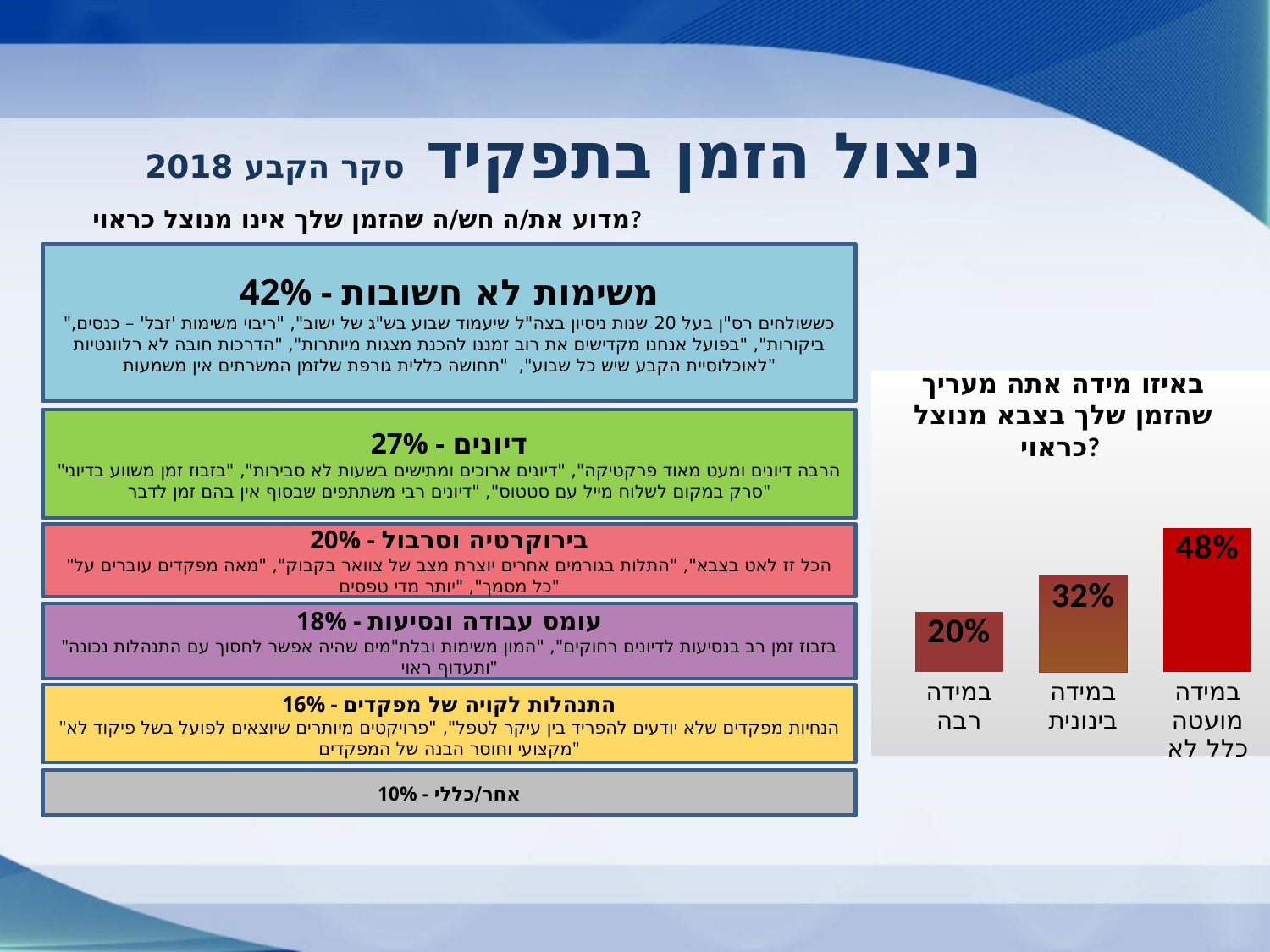
In the bar chart on the right, which category has the highest value? במידה מועטה כלל לא In the bar chart on the right, what is the difference between the values for "במידה מועטה כלל לא" and "במידה רבה"? 28% What is the title of the bar chart on the right? באיזו מידה אתה מעריך שהזמן שלך בצבא מנוצל כראוי? In the bar chart on the right, which is larger: the value for "במידה בינונית" or the value for "במידה רבה"? במידה בינונית In the bar chart on the right, which category has the lowest value? במידה רבה In the bar chart on the right, do the values rise or fall when reading the bars from left to right? Rise What kind of chart is shown on the right side of the slide? Bar chart In the bar chart on the right, what is the value for "במידה רבה"? 20% In the bar chart on the right, what is the value for "במידה בינונית"? 32% How many categories are shown in the bar chart on the right? 3 In the bar chart on the right, what is the difference between the values for "במידה בינונית" and "במידה רבה"? 12% In the bar chart on the right, what is the value for "במידה מועטה כלל לא"? 48%